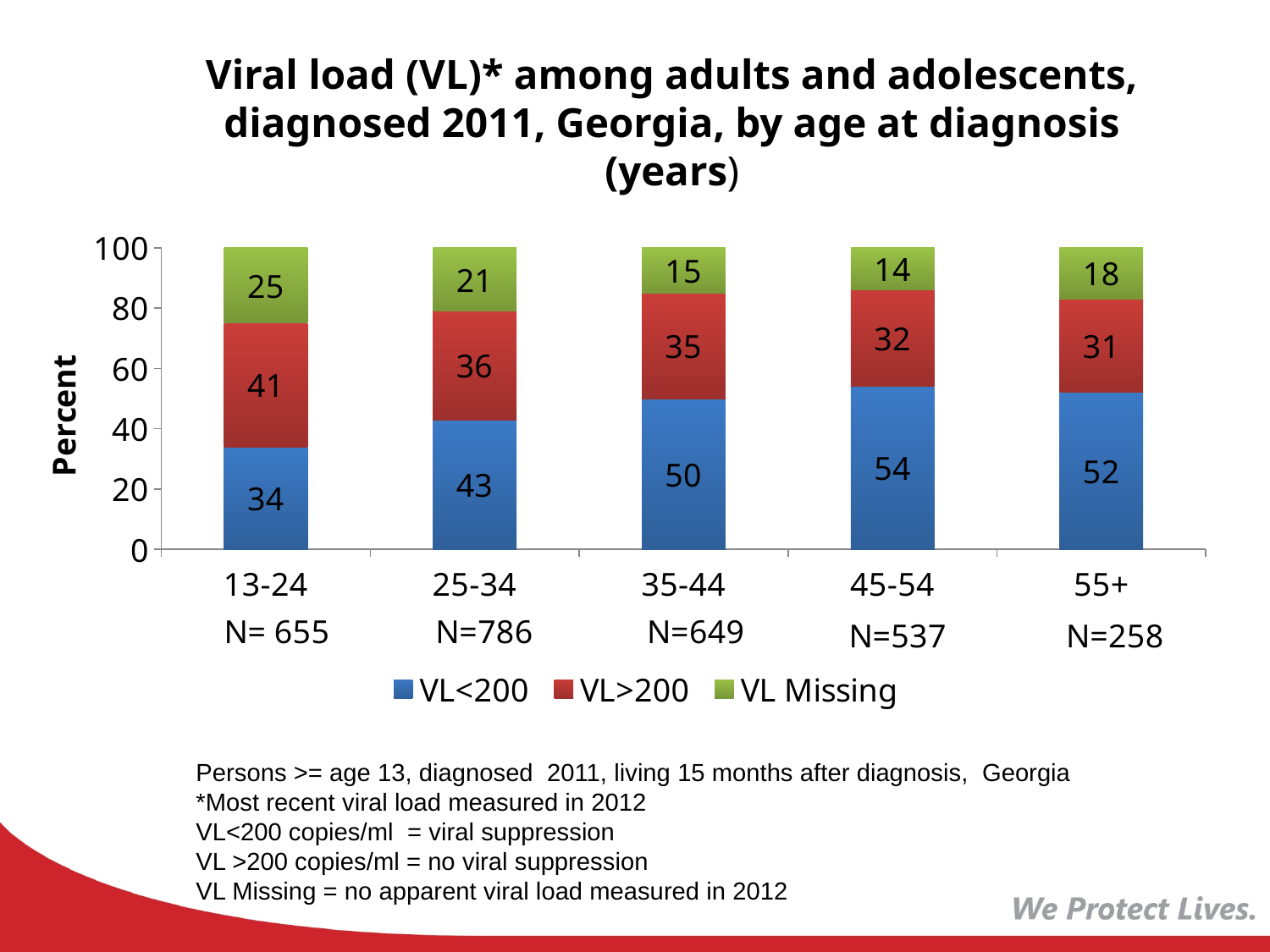
What is the total of the stacked bar for the 35-44 age group? 100 How many age groups are shown on the x axis? 5 What is the label of the y axis? Percent Which age group has the highest VL<200 value? 45-54 What is the VL<200 value for the 13-24 age group? 34 Which age group has the lowest VL Missing value? 45-54 What is the VL Missing value for the 45-54 age group? 14 How many series does the legend list? 3 What is the VL>200 value for the 25-34 age group? 36 What kind of chart is shown on the slide? Stacked bar chart What is the difference between the VL<200 values for the 45-54 and 13-24 age groups? 20 Which is larger, the VL>200 value for 13-24 or for 55+? 13-24